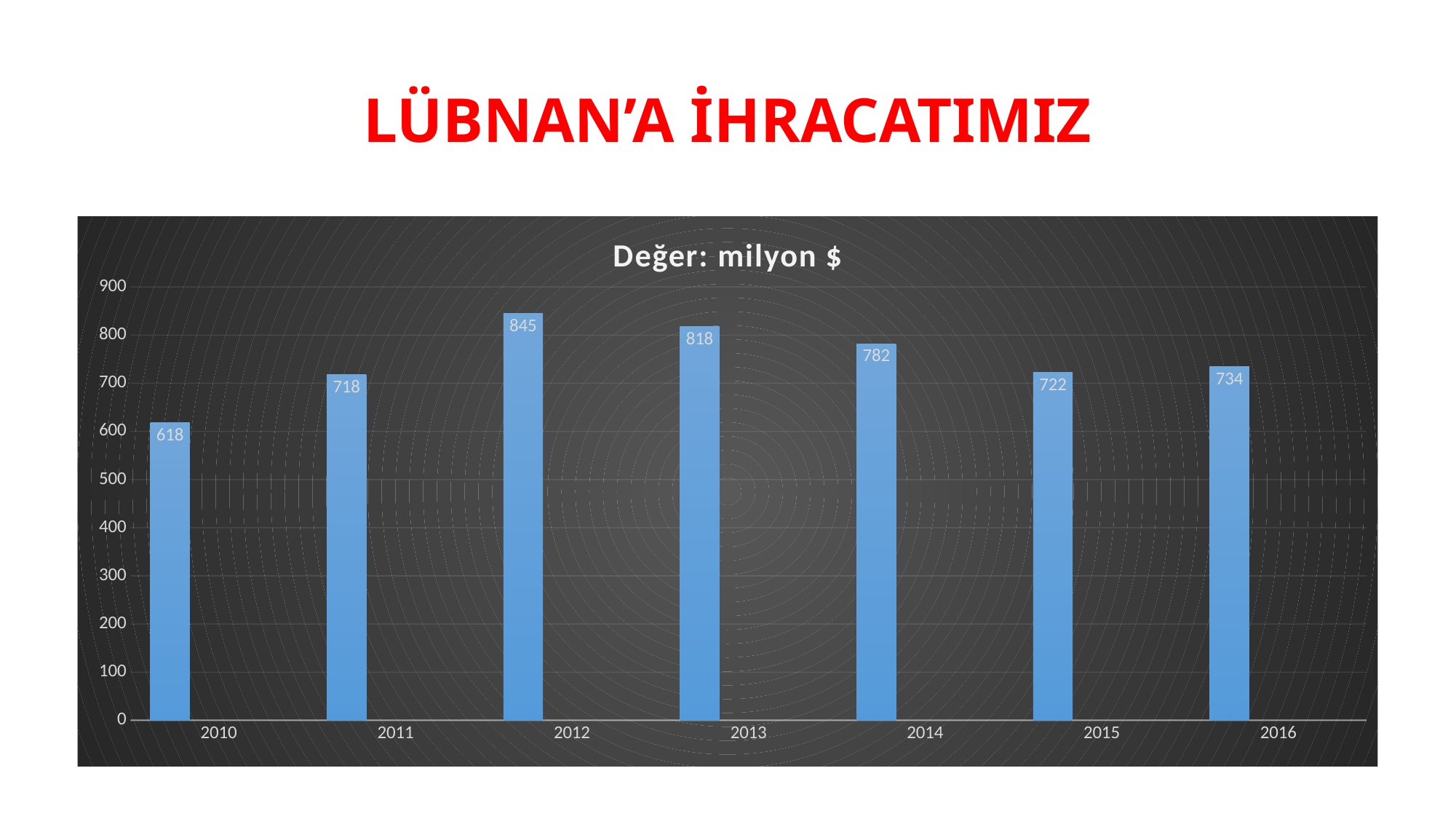
Which year has the highest value? 2012 Which year has the lowest value? 2010 What is the chart's title? Değer: milyon $ What is the value for 2010? 618 What is the difference between the values for 2011 and 2010? 100 What is the value for 2015? 722 Is the value for 2013 greater or less than 800? greater What is the value for 2012? 845 Which is larger, the value for 2014 or the value for 2016? 2014 How many years are shown on the x axis? 7 What kind of chart is shown on the slide? bar chart What is the difference between the values for 2012 and 2013? 27